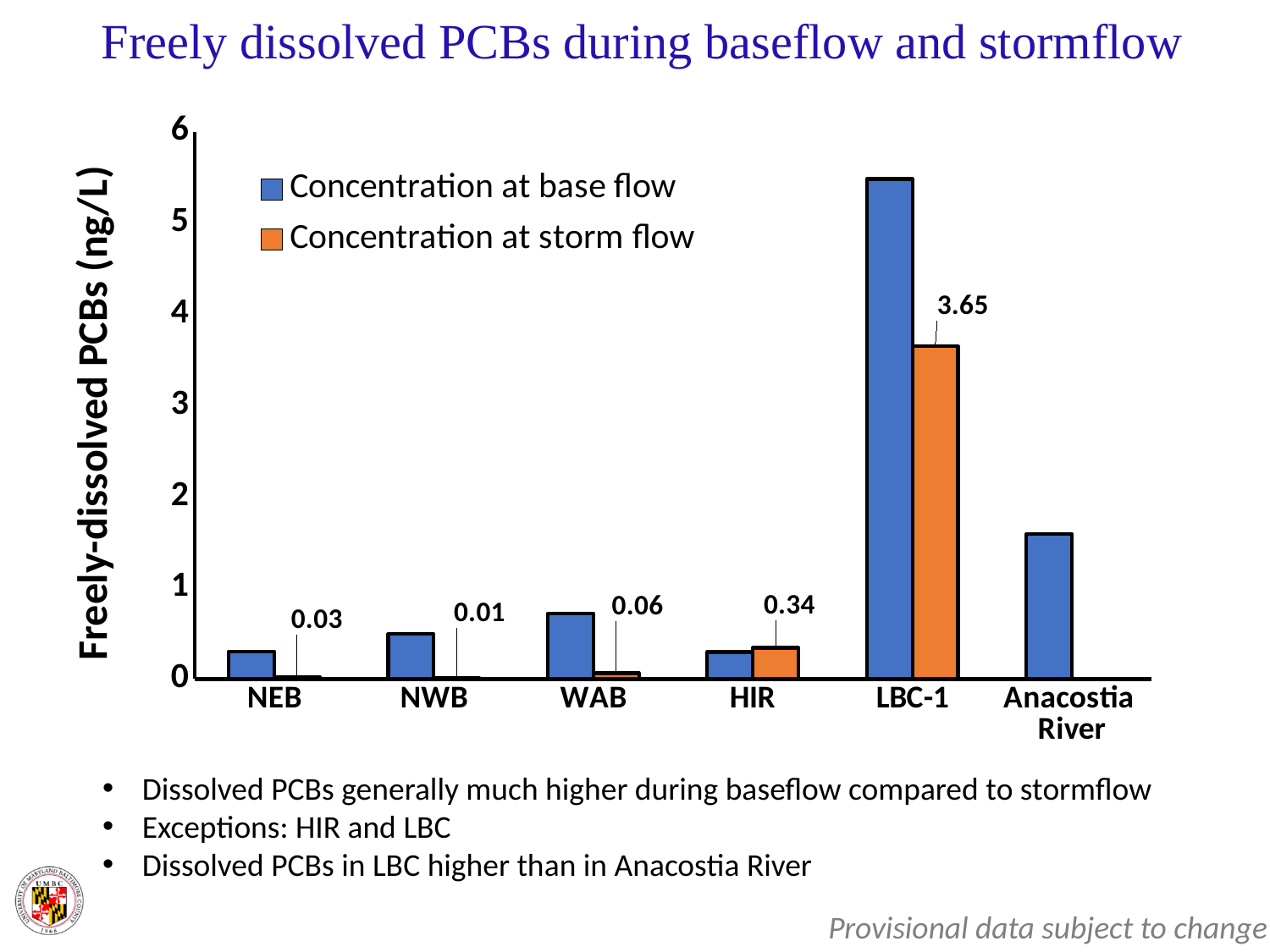
Which site has the highest concentration at storm flow? LBC-1 Is the concentration at base flow for LBC-1 greater or less than 5? greater What is the difference between the storm flow concentrations at LBC-1 and HIR? 3.31 Is the concentration at base flow for Anacostia River greater or less than 1? greater What is the concentration at storm flow for LBC-1? 3.65 What is the concentration at storm flow for HIR? 0.34 How many sites are shown on the x axis? 6 What kind of chart is shown on the slide? Bar chart Which site has the lowest labelled concentration at storm flow? NWB What is the concentration at storm flow for NWB? 0.01 Which is larger, the storm flow concentration at WAB or at NEB? WAB How many series does the legend list? 2